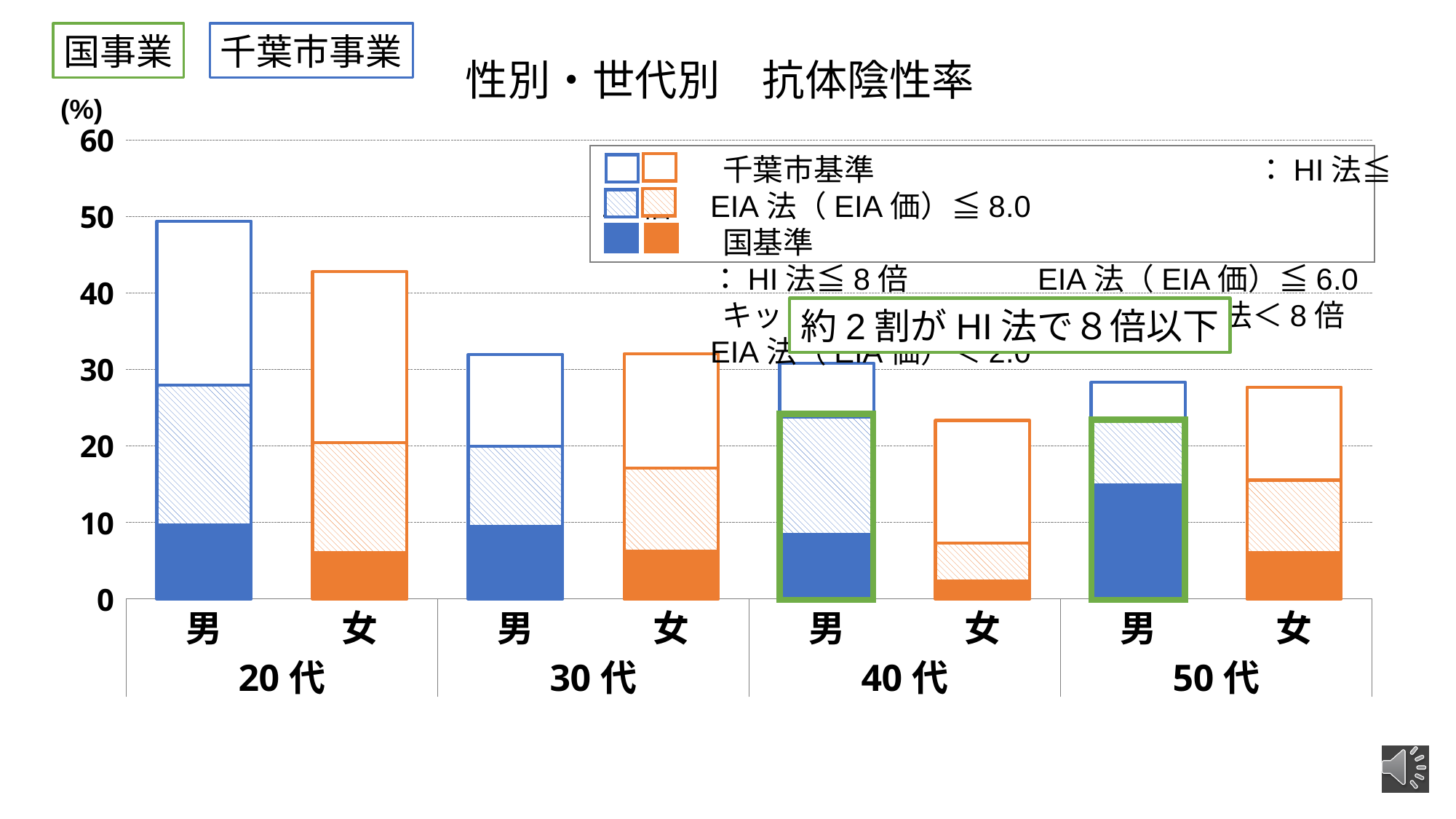
Is the total value for 40代 女 greater or less than 30? less What kind of chart is shown on the slide? stacked bar chart Which has the larger total value, 40代 男 or 40代 女? 40代 男 Which bar has the highest total value in the chart? 20代 男 Which has the larger total value, 20代 男 or 20代 女? 20代 男 Which bar has the lowest total value in the chart? 40代 女 What is the title of the chart? 性別・世代別 抗体陰性率 How many bars are plotted in the chart? 8 What unit is shown on the y axis of the chart? % Is the total value for 20代 男 greater or less than 40? greater Is the total value for 50代 男 greater or less than 30? less